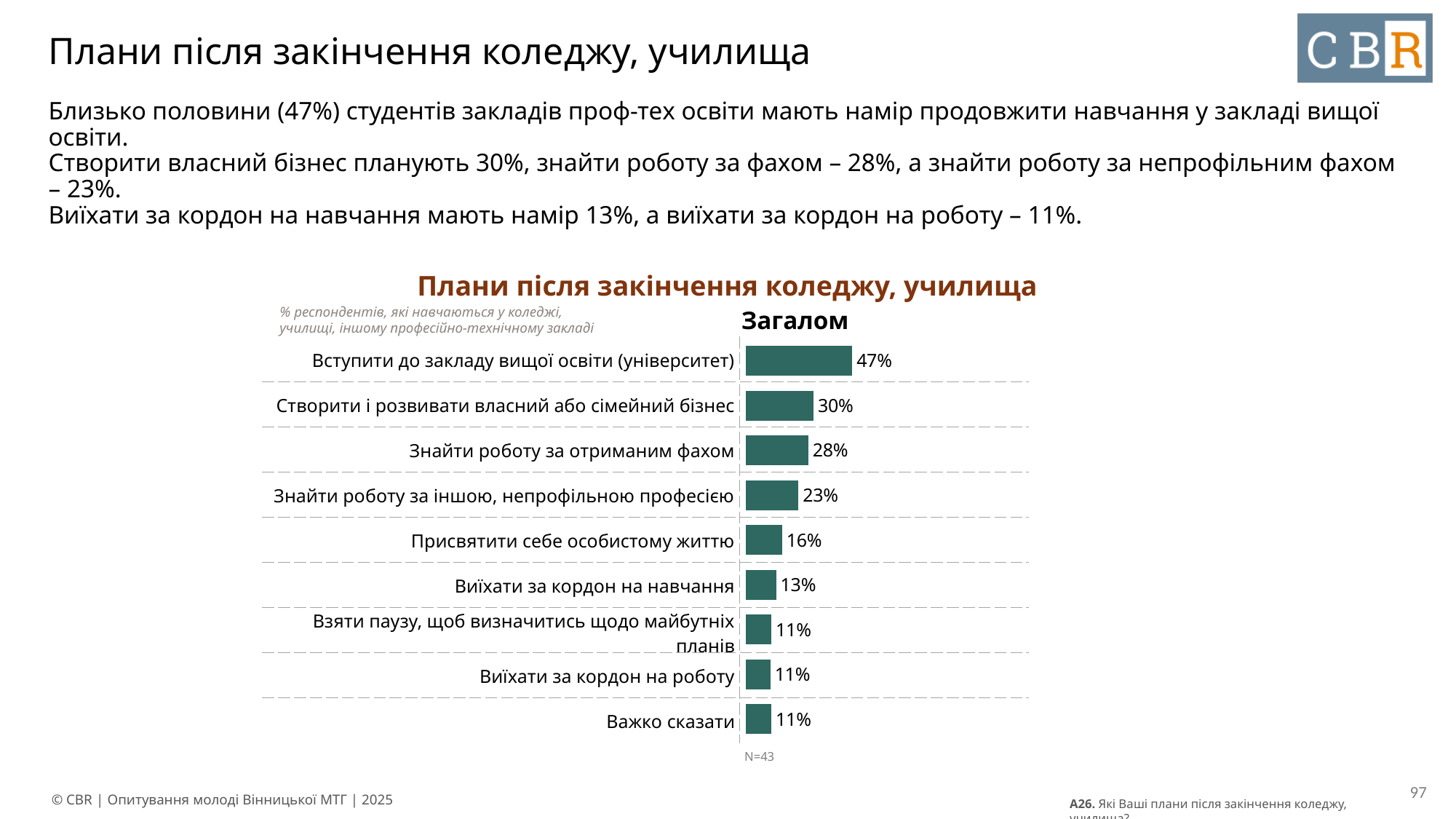
What is the difference between "Вступити до закладу вищої освіти (університет)" and "Знайти роботу за іншою, непрофільною професією"? 24% What is the sample size (N) shown under the chart? N=43 What is the value for "Знайти роботу за отриманим фахом"? 28% What kind of chart is shown on the slide? Bar chart Which is larger: "Знайти роботу за іншою, непрофільною професією" or "Присвятити себе особистому життю"? Знайти роботу за іншою, непрофільною професією How many categories are shown in the chart? 9 Which category has the highest value? Вступити до закладу вищої освіти (університет) What is the value for "Присвятити себе особистому життю"? 16% What is the difference between "Створити і розвивати власний або сімейний бізнес" and "Знайти роботу за отриманим фахом"? 2% What is the value for "Виїхати за кордон на навчання"? 13% What is the value for "Вступити до закладу вищої освіти (університет)"? 47% What is the title of the chart? Плани після закінчення коледжу, училища